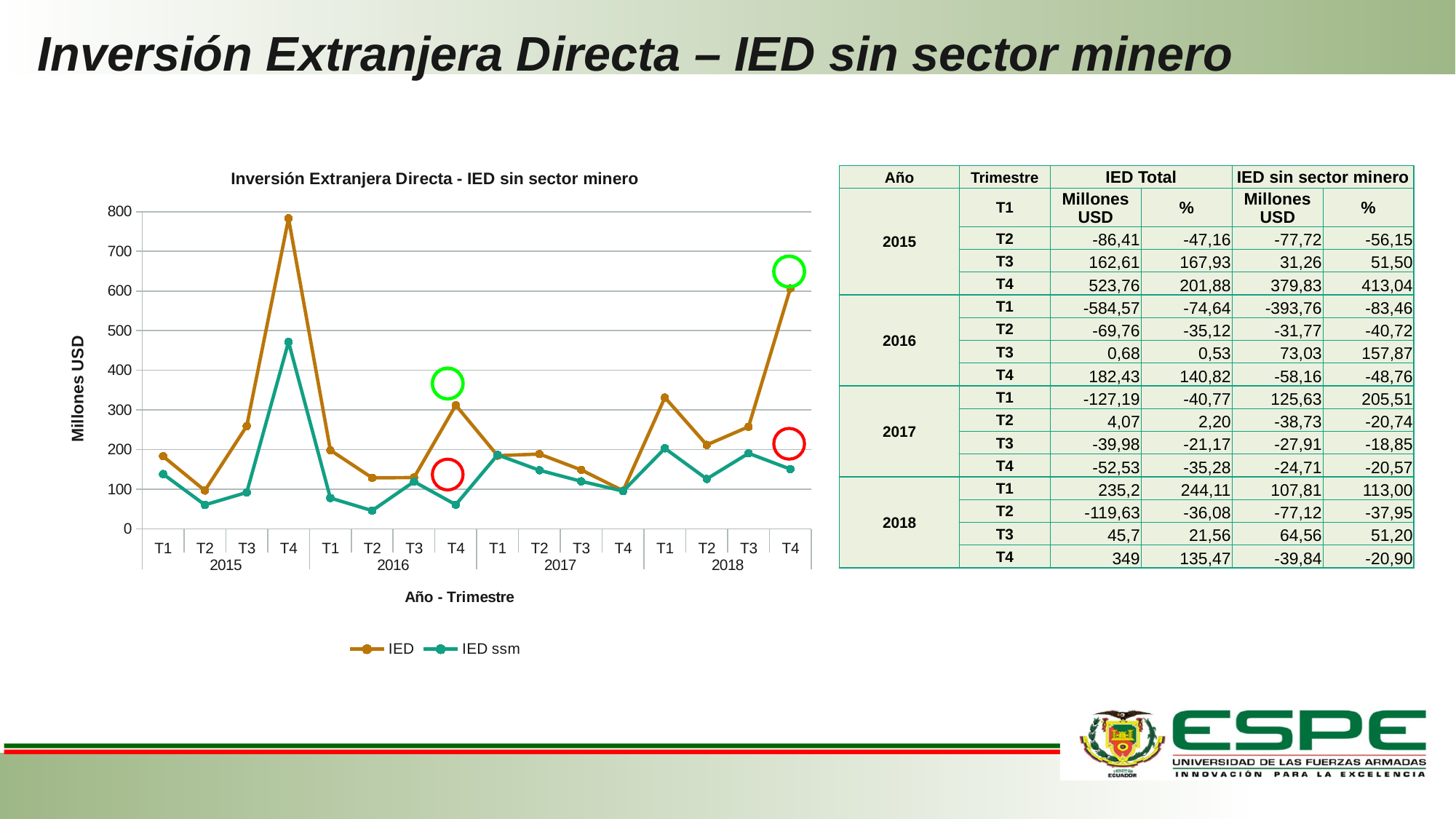
Does the IED series rise or fall from T2 2018 to T4 2018? rise At T4 2016, which series has the larger value, IED or IED ssm? IED Is the IED value for T4 2015 greater or less than 700? greater Is the IED ssm value for T4 2015 greater or less than 400? greater In which quarter does the IED ssm series reach its lowest value? T2 2016 In which quarter does the IED series reach its highest value? T4 2015 What kind of chart is shown on the slide? line chart How many series does the chart legend list? 2 Is the IED value for T4 2018 greater or less than 500? greater How many quarterly points are plotted along the x axis of the chart? 16 What is the title of the chart's vertical axis? Millones USD In which quarter does the IED ssm series reach its highest value? T4 2015